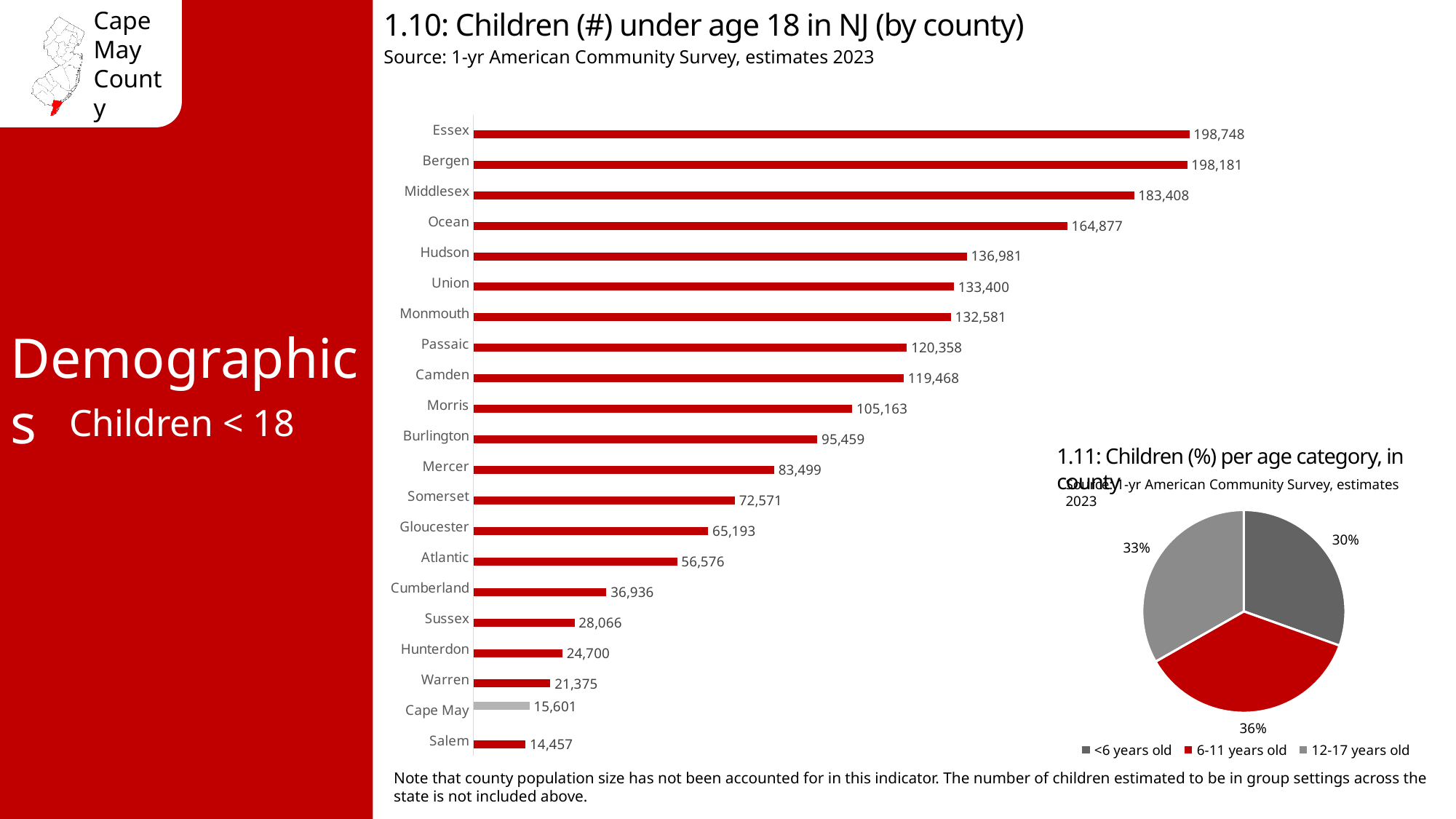
In the pie chart '1.11: Children (%) per age category, in county', which age category has the smallest share? <6 years old In the chart '1.10: Children (#) under age 18 in NJ (by county)', what is the value for Ocean? 164,877 In the chart '1.10: Children (#) under age 18 in NJ (by county)', which county has the highest number of children under 18? Essex In the pie chart '1.11: Children (%) per age category, in county', what share is 6-11 years old? 36% In the chart '1.10: Children (#) under age 18 in NJ (by county)', what is the difference between the values for Ocean and Hudson? 27,896 In the chart '1.10: Children (#) under age 18 in NJ (by county)', what is the difference between the values for Cape May and Salem? 1,144 How many counties are shown in the chart '1.10: Children (#) under age 18 in NJ (by county)'? 21 In the chart '1.10: Children (#) under age 18 in NJ (by county)', how many children under 18 are in Cape May? 15,601 In the chart '1.10: Children (#) under age 18 in NJ (by county)', which county has the lowest number of children under 18? Salem In the chart '1.10: Children (#) under age 18 in NJ (by county)', which has more children under 18, Morris or Burlington? Morris What type of chart is '1.10: Children (#) under age 18 in NJ (by county)'? Bar chart How many categories does the legend of the pie chart '1.11: Children (%) per age category, in county' list? 3